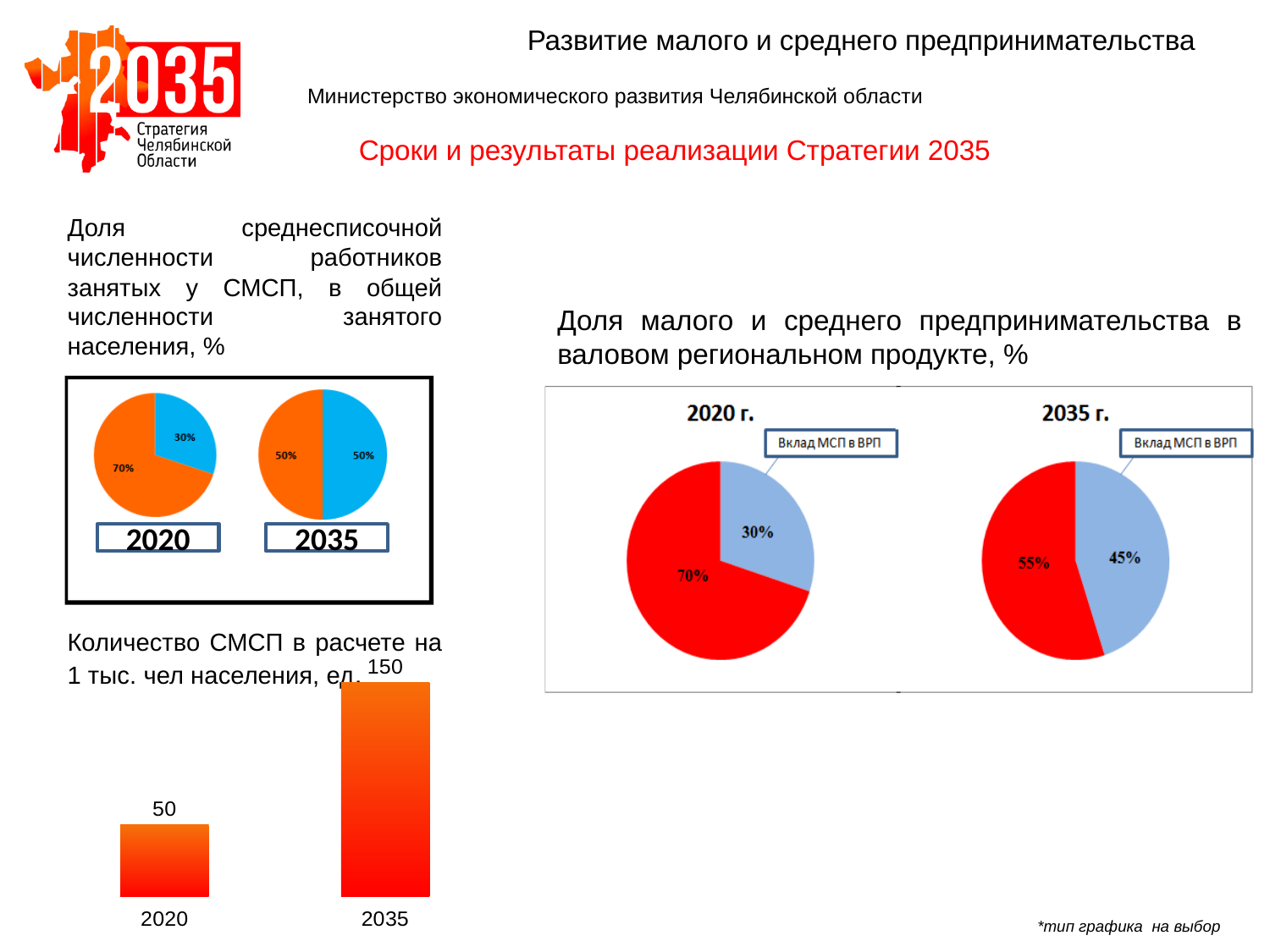
In the bar chart at the bottom left, how many bars are plotted? 2 In the pie charts on the right, which is larger for 2035 г.: the red slice or the blue slice? the red slice (55%) In the bar chart at the bottom left, do the values rise or fall from 2020 to 2035? rise In the bar chart at the bottom left, what is the difference between the 2035 and 2020 values? 100 In the pie charts on the right (Доля малого и среднего предпринимательства в валовом региональном продукте, %), what is the red slice for 2020 г.? 70% In the pie charts on the right (Доля малого и среднего предпринимательства в валовом региональном продукте, %), what is the blue slice (Вклад МСП в ВРП) for 2035 г.? 45% In the bar chart at the bottom left (Количество СМСП в расчете на 1 тыс. чел населения, ед.), what is the value for 2035? 150 In the pie charts at the top left (Доля среднесписочной численности работников занятых у СМСП), what is the blue slice for 2020? 30% In the bar chart at the bottom left (Количество СМСП в расчете на 1 тыс. чел населения, ед.), what is the value for 2020? 50 What kind of chart is used at the bottom left of the slide for Количество СМСП в расчете на 1 тыс. чел населения? bar chart In the pie charts at the top left (Доля среднесписочной численности работников занятых у СМСП), what is the orange slice for 2035? 50% In the bar chart at the bottom left, which year has the higher value? 2035